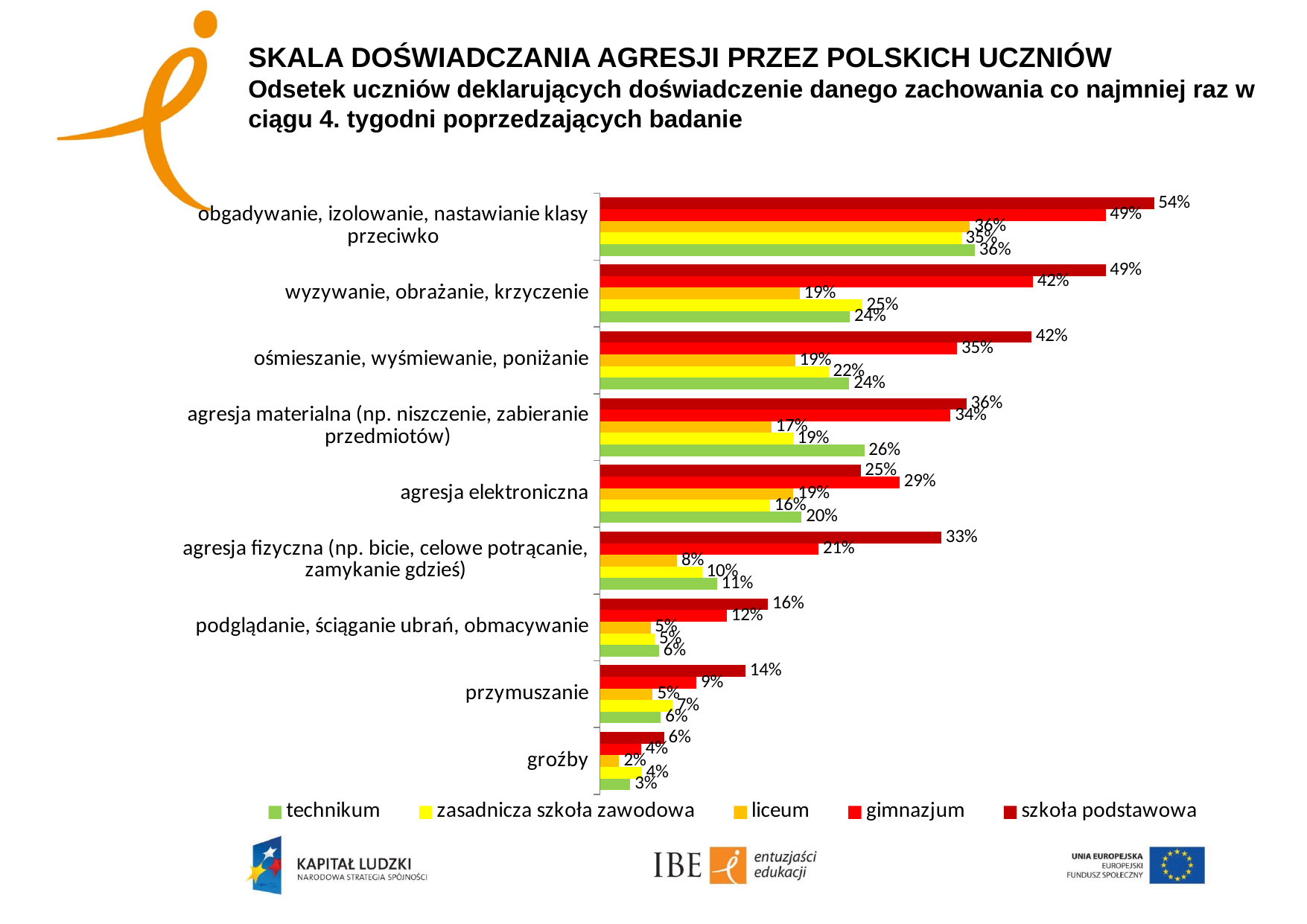
Which category has the highest value for szkoła podstawowa? obgadywanie, izolowanie, nastawianie klasy przeciwko How many categories of behaviour are shown on the chart? 9 What is the value for technikum in the category 'agresja materialna (np. niszczenie, zabieranie przedmiotów)'? 26% What is the value for szkoła podstawowa in the category 'obgadywanie, izolowanie, nastawianie klasy przeciwko'? 54% Which series is shown in green in the legend? technikum In the category 'agresja elektroniczna', which is larger: the value for szkoła podstawowa or for gimnazjum? gimnazjum What is the value for liceum in the category 'agresja fizyczna (np. bicie, celowe potrącanie, zamykanie gdzieś)'? 8% How many series does the legend list? 5 Which category has the lowest value for gimnazjum? groźby What is the difference between the szkoła podstawowa and gimnazjum values in the category 'agresja fizyczna (np. bicie, celowe potrącanie, zamykanie gdzieś)'? 12% What is the value for gimnazjum in the category 'agresja elektroniczna'? 29% What type of chart is shown on the slide? bar chart